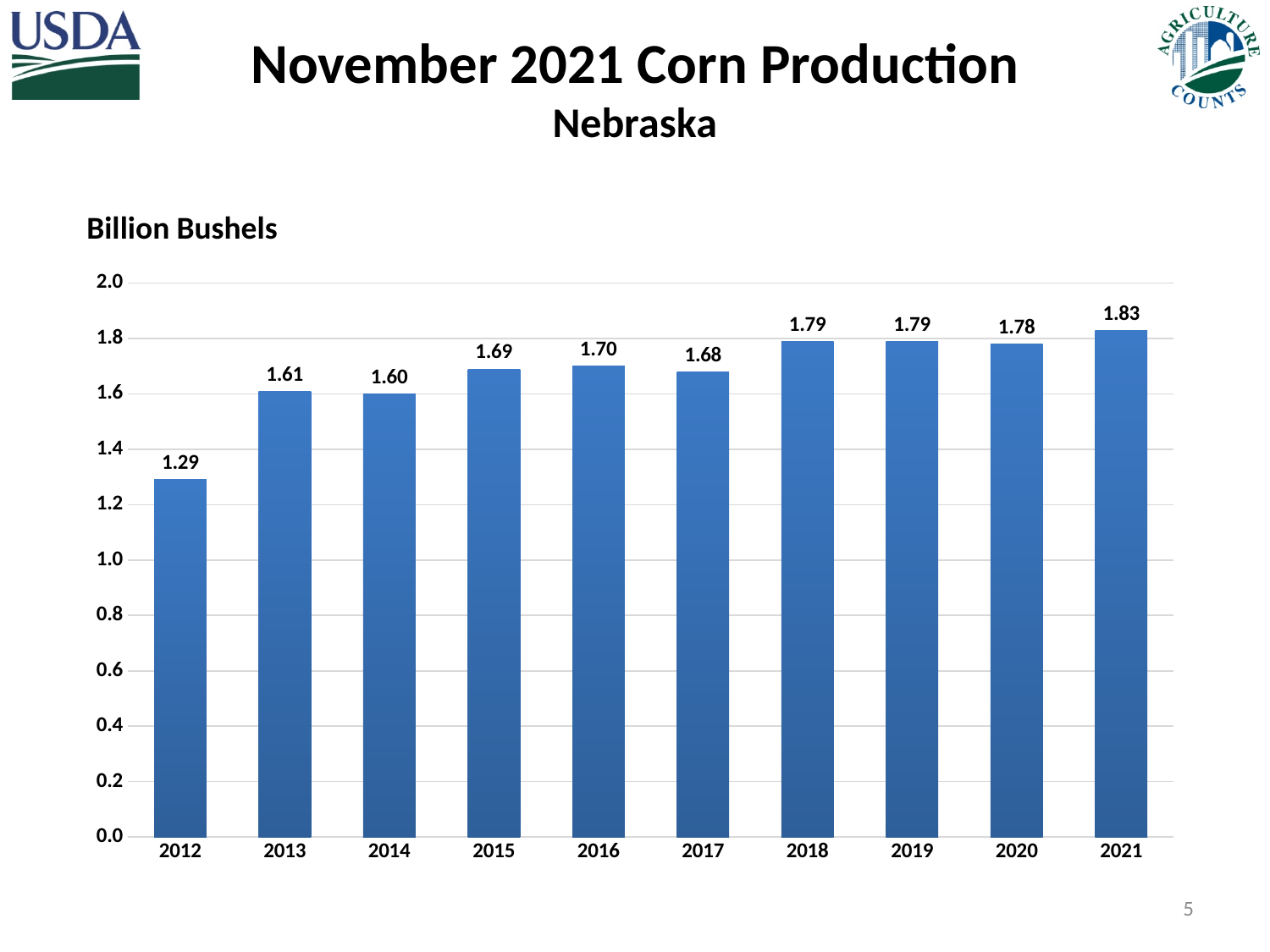
How many years are shown on the chart? 10 What was the corn production value for 2017? 1.68 Which is larger, the value for 2013 or the value for 2014? 2013 What is the difference between the 2021 value and the 2012 value? 0.54 What unit is the chart's vertical axis measured in? Billion Bushels What is the difference between the 2016 value and the 2017 value? 0.02 What value is shown for 2021? 1.83 Which year has the highest corn production? 2021 What kind of chart is shown on the slide? bar chart What was Nebraska's corn production in 2012, in billion bushels? 1.29 Which year has the lowest corn production? 2012 Is the value for 2015 greater or less than 1.6? greater